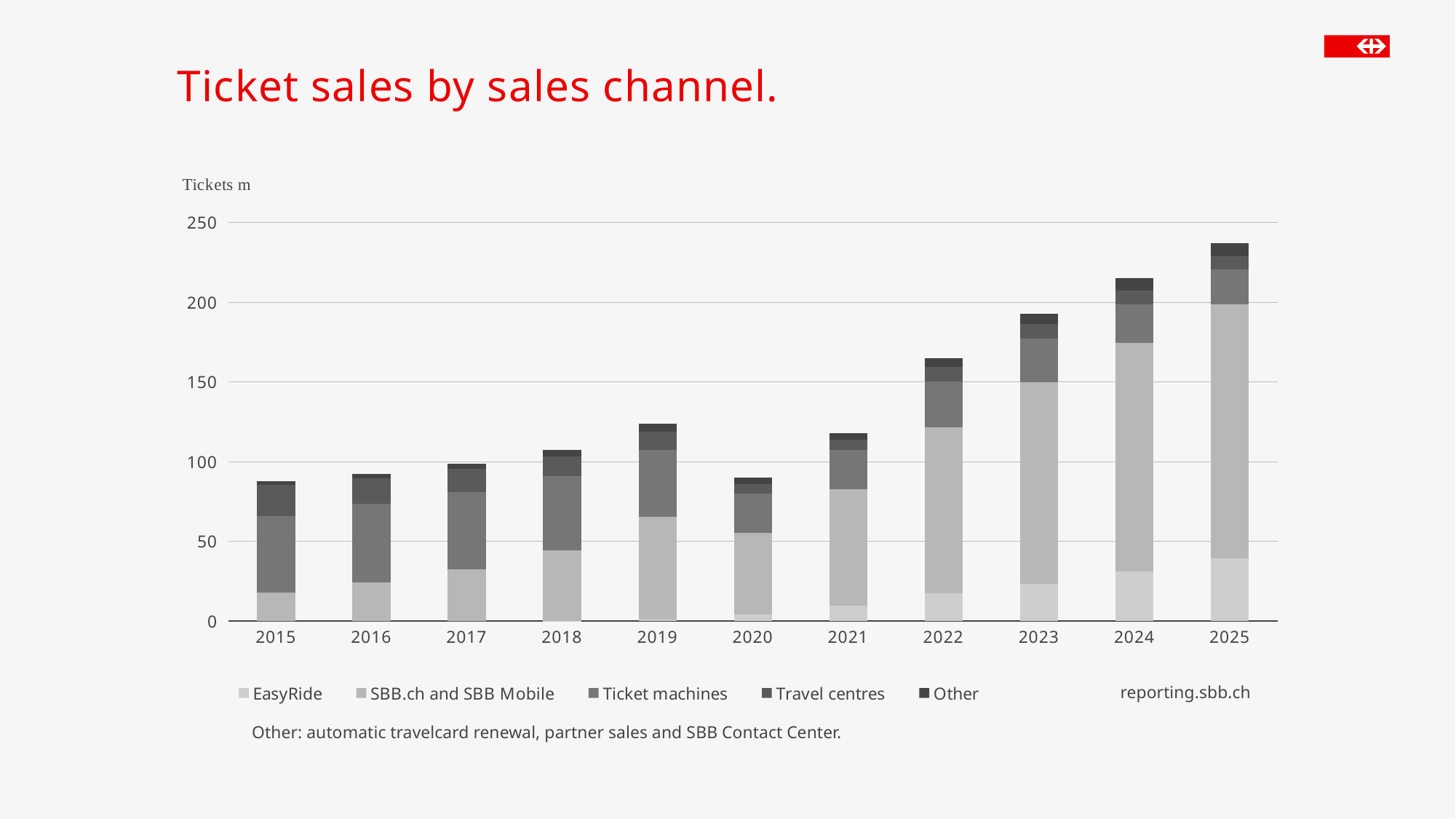
How many series does the chart's legend list? 5 What is the title of the chart on the slide? Ticket sales by sales channel. What kind of chart is shown on the slide? Stacked bar chart Is the total ticket sales value for 2015 greater or less than 100? less Which year has the larger total ticket sales, 2023 or 2024? 2024 Is the total ticket sales value for 2022 greater or less than 150? greater Do total ticket sales generally rise or fall from 2015 to 2025? rise How many years are shown on the x axis of the chart? 11 Which year has the highest total ticket sales in the chart? 2025 Is the total ticket sales value for 2025 greater or less than 200? greater What unit label is shown above the y axis of the chart? Tickets m